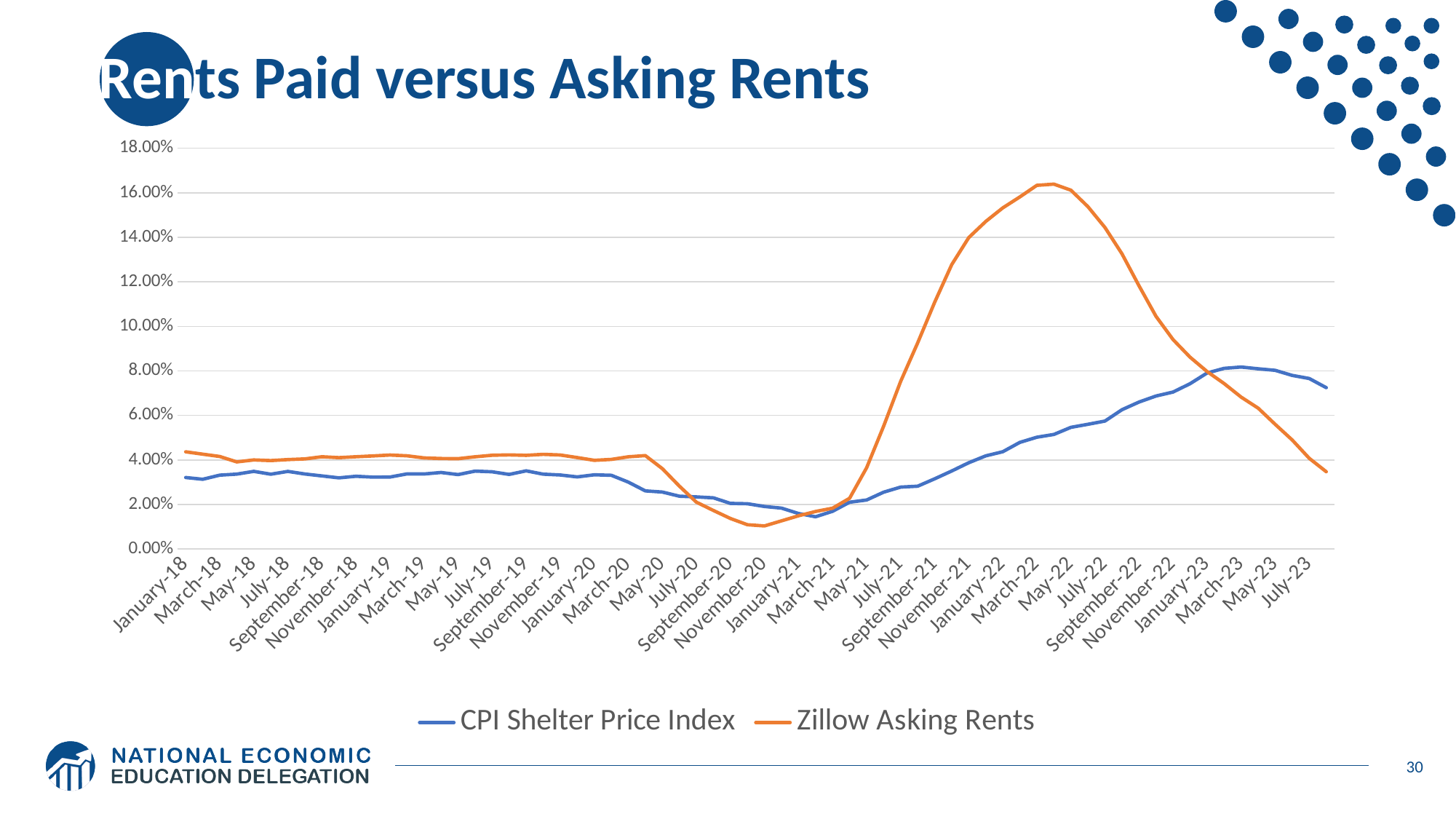
How many series does the legend list? 2 What kind of chart is shown on the slide? Line chart Which series is drawn in orange? Zillow Asking Rents Is the value for CPI Shelter Price Index at January-18 greater or less than 4.00%? less Which series reaches the highest value anywhere on the chart? Zillow Asking Rents Is the value for Zillow Asking Rents at March-22 greater or less than 14.00%? greater At March-22, which series has the higher value, CPI Shelter Price Index or Zillow Asking Rents? Zillow Asking Rents Does the Zillow Asking Rents line rise or fall between May-22 and July-23? Fall At March-23, which series has the higher value, CPI Shelter Price Index or Zillow Asking Rents? CPI Shelter Price Index Is the value for Zillow Asking Rents at November-20 greater or less than 2.00%? less What is the title of the chart? Rents Paid versus Asking Rents